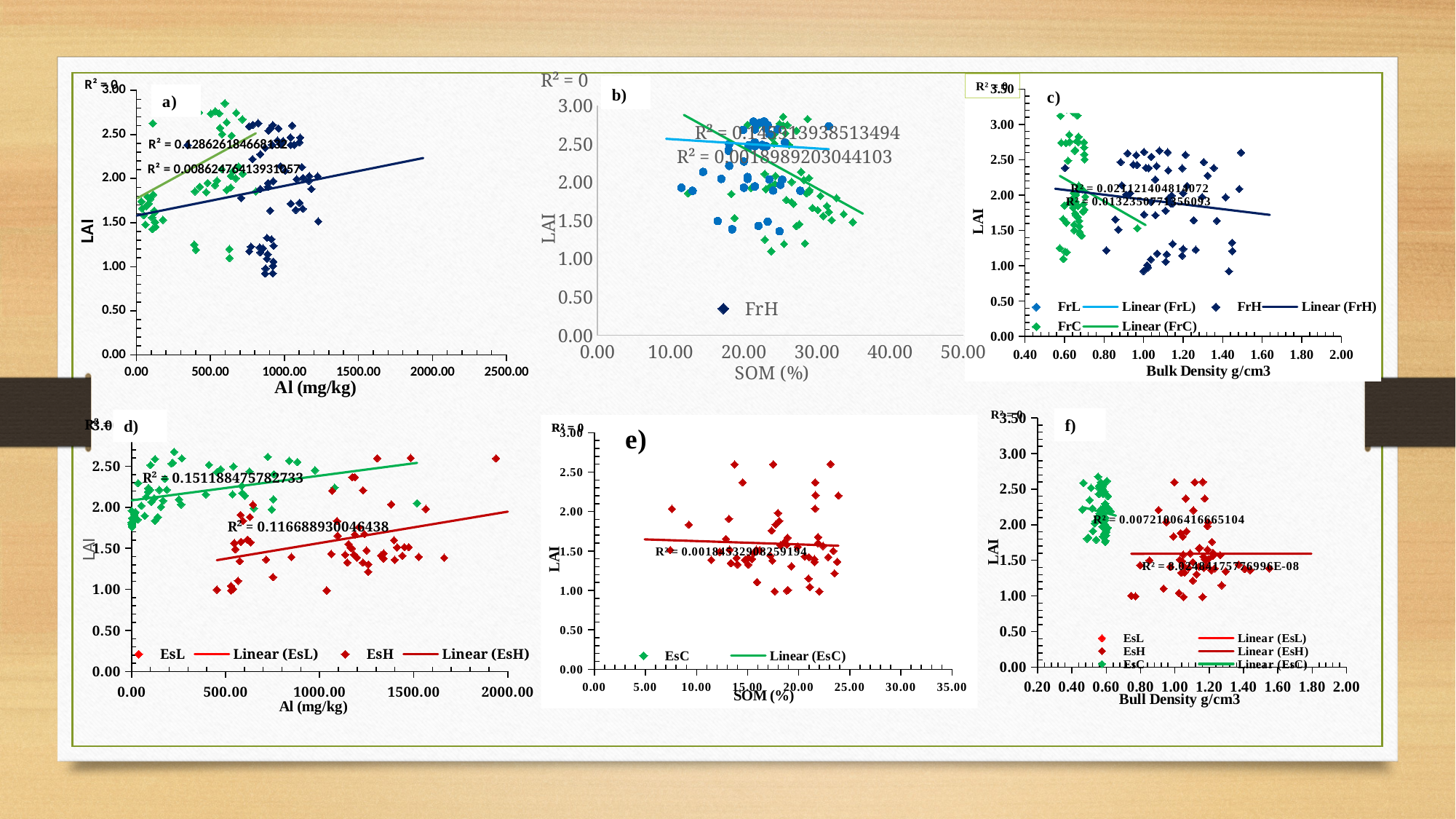
What is the x-axis label of chart c)? Bulk Density g/cm3 In chart a), what is the R² value printed for the navy trend line? R² = 0.00862476413931257 In chart b), does the green trend line rise or fall as SOM (%) increases? fall What kind of chart is chart a)? scatter chart How many series does the legend of chart c) list (excluding the linear trend lines)? 3 What is the x-axis label of chart a)? Al (mg/kg) In chart e), what is the R² value printed on the chart? R² = 0.00184332908259194 In chart d), what is the R² value printed for the red trend line? R² = 0.116688930046438 In chart d), what is the R² value printed for the green trend line? R² = 0.151188475782733 In chart a), does the navy trend line rise or fall as Al (mg/kg) increases? rise